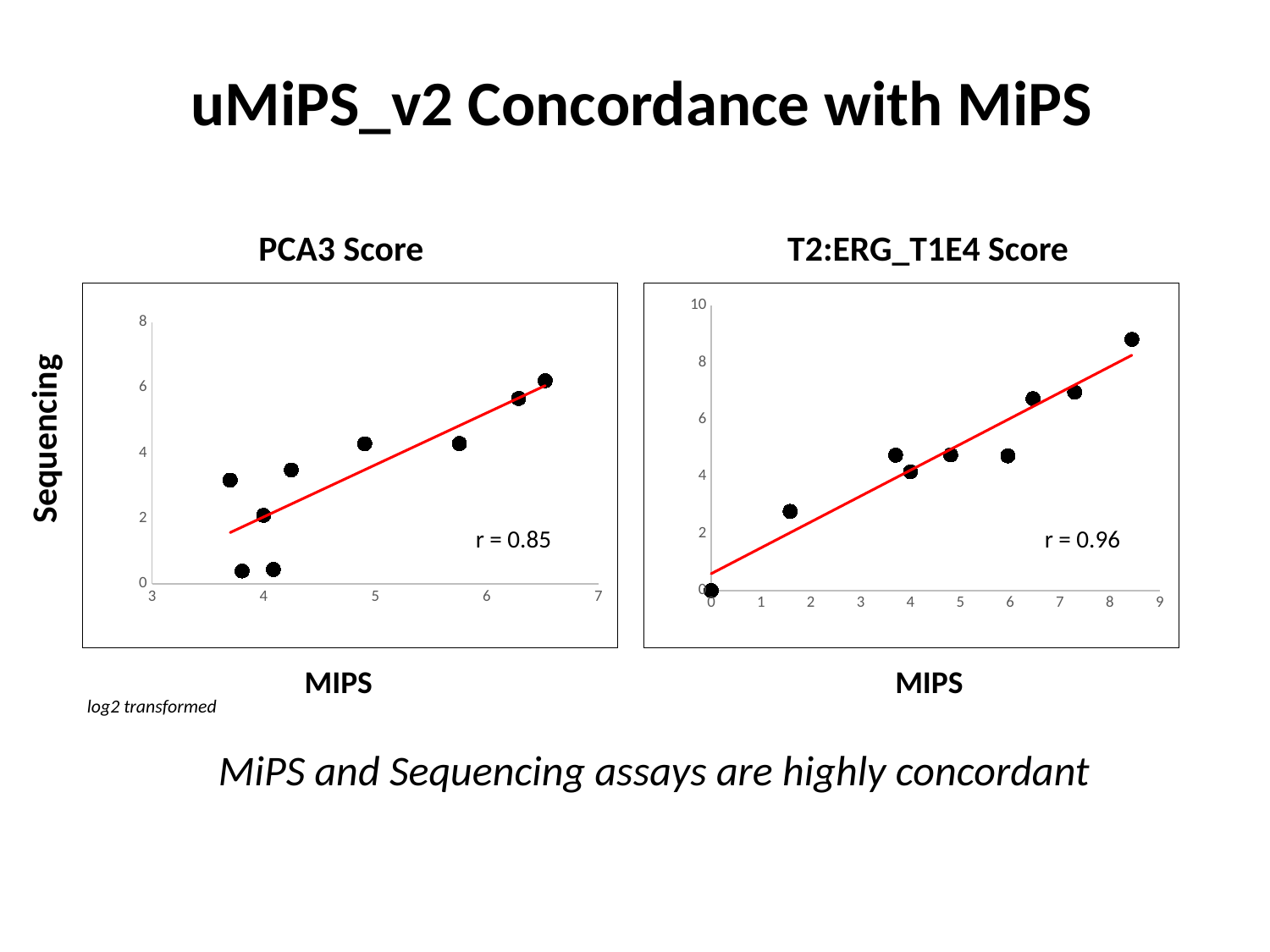
How many data points are plotted in the PCA3 Score chart? 9 In the PCA3 Score chart, what correlation coefficient (r) is shown? r = 0.85 In the PCA3 Score chart, is the Sequencing value of the rightmost point greater or less than 4? greater How many data points are plotted in the T2:ERG_T1E4 Score chart? 9 In the T2:ERG_T1E4 Score chart, what correlation coefficient (r) is shown? r = 0.96 What kind of chart is the PCA3 Score chart? scatter plot What is the difference between the correlation coefficients of the T2:ERG_T1E4 Score chart and the PCA3 Score chart? 0.11 What kind of chart is the T2:ERG_T1E4 Score chart? scatter plot In the T2:ERG_T1E4 Score chart, is the Sequencing value of the rightmost point greater or less than 8? greater What is the label of the x axis on both charts? MIPS In the T2:ERG_T1E4 Score chart, do the Sequencing values generally rise or fall as the MIPS values increase? rise Which chart shows the higher correlation coefficient, PCA3 Score or T2:ERG_T1E4 Score? T2:ERG_T1E4 Score